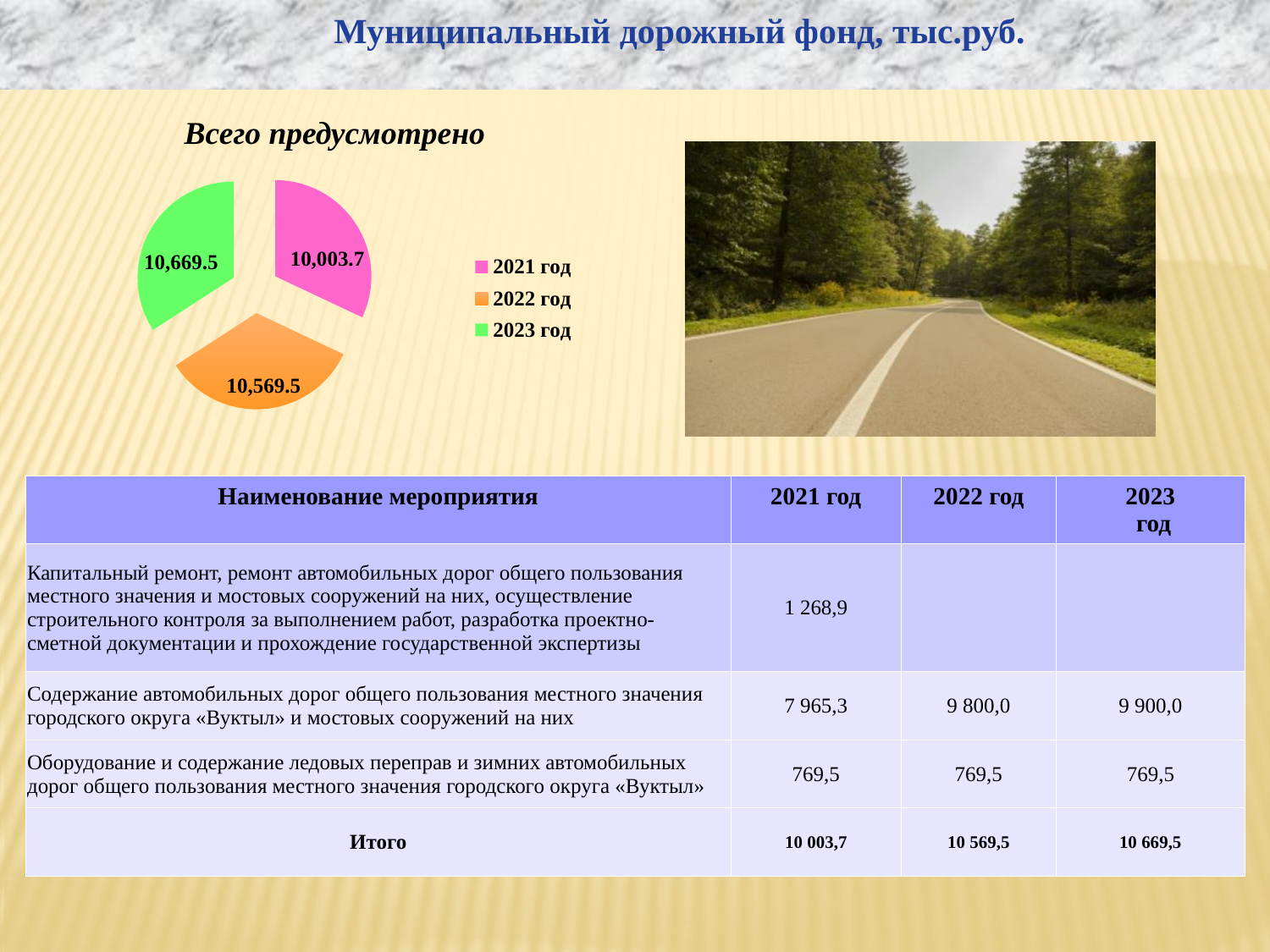
What kind of chart is shown on the slide? Pie chart What colour is the slice for 2022 год in the pie chart? Orange In the pie chart, what is the value for 2022 год? 10,569.5 How many entries does the pie chart's legend list? 3 Which year has the largest slice in the pie chart? 2023 год What is the difference between the values for 2022 год and 2021 год in the pie chart? 565.8 Which year has the smallest slice in the pie chart? 2021 год How many slices does the pie chart have? 3 In the pie chart, what is the value for 2021 год? 10,003.7 In the pie chart, which is larger: the value for 2022 год or the value for 2021 год? 2022 год In the pie chart, what is the value for 2023 год? 10,669.5 What is the difference between the values for 2023 год and 2022 год in the pie chart? 100.0